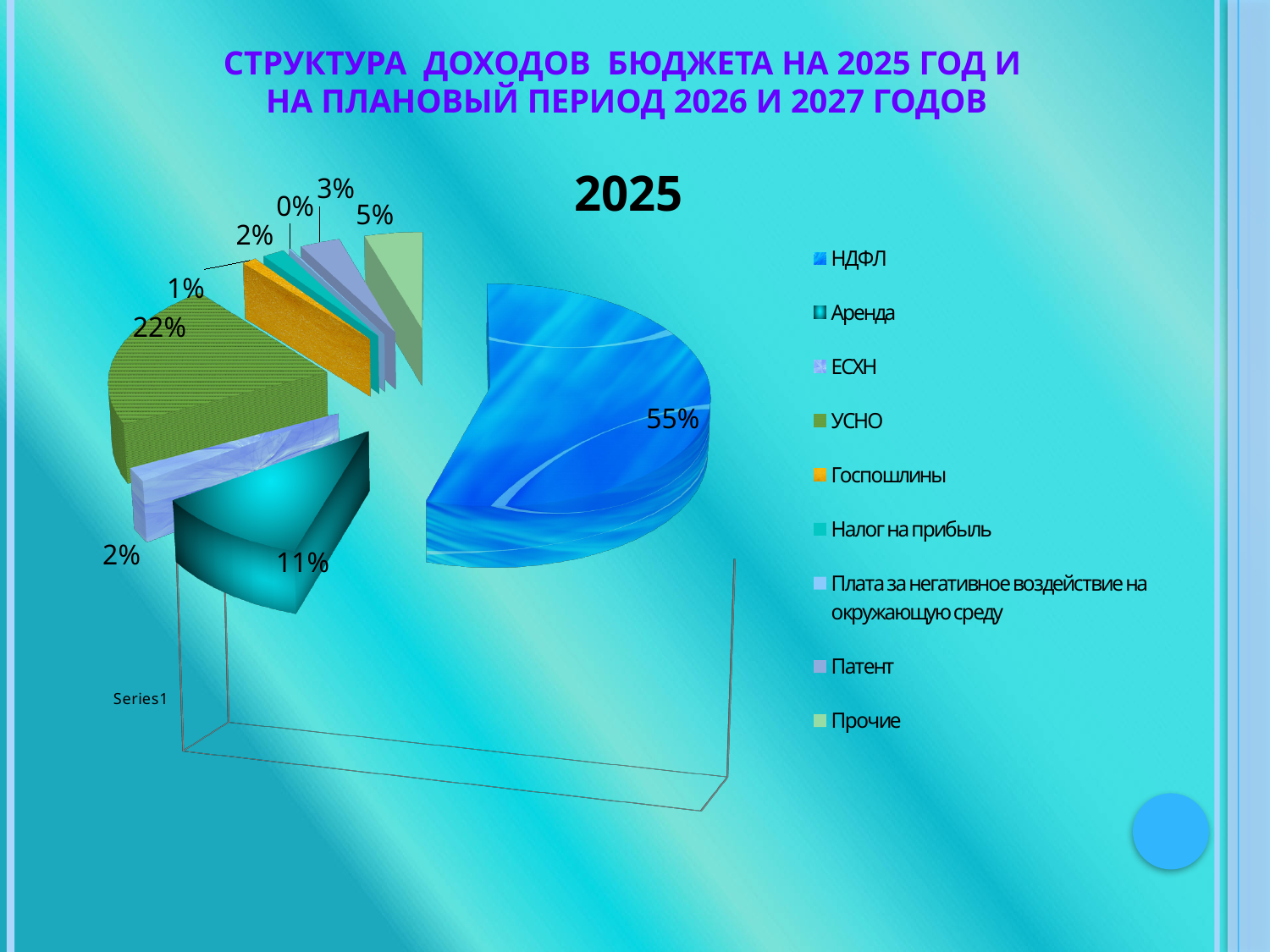
How many revenue categories does the legend list? 9 What year is shown as the title of the pie chart? 2025 What kind of chart is shown on the slide? pie chart By how many percentage points does the НДФЛ share exceed the УСНО share? 33 percentage points What share of the 2025 budget revenue does НДФЛ account for? 55% Which revenue source has the largest share in the 2025 pie chart? НДФЛ What share of the 2025 budget revenue does УСНО account for? 22% What share of the 2025 budget revenue does Аренда account for? 11% Which has the larger share, УСНО or Аренда? УСНО What is the smallest percentage value labelled on the pie chart? 0% What is the combined share of НДФЛ, УСНО and Аренда? 88% What share of the 2025 budget revenue does Прочие account for? 5%